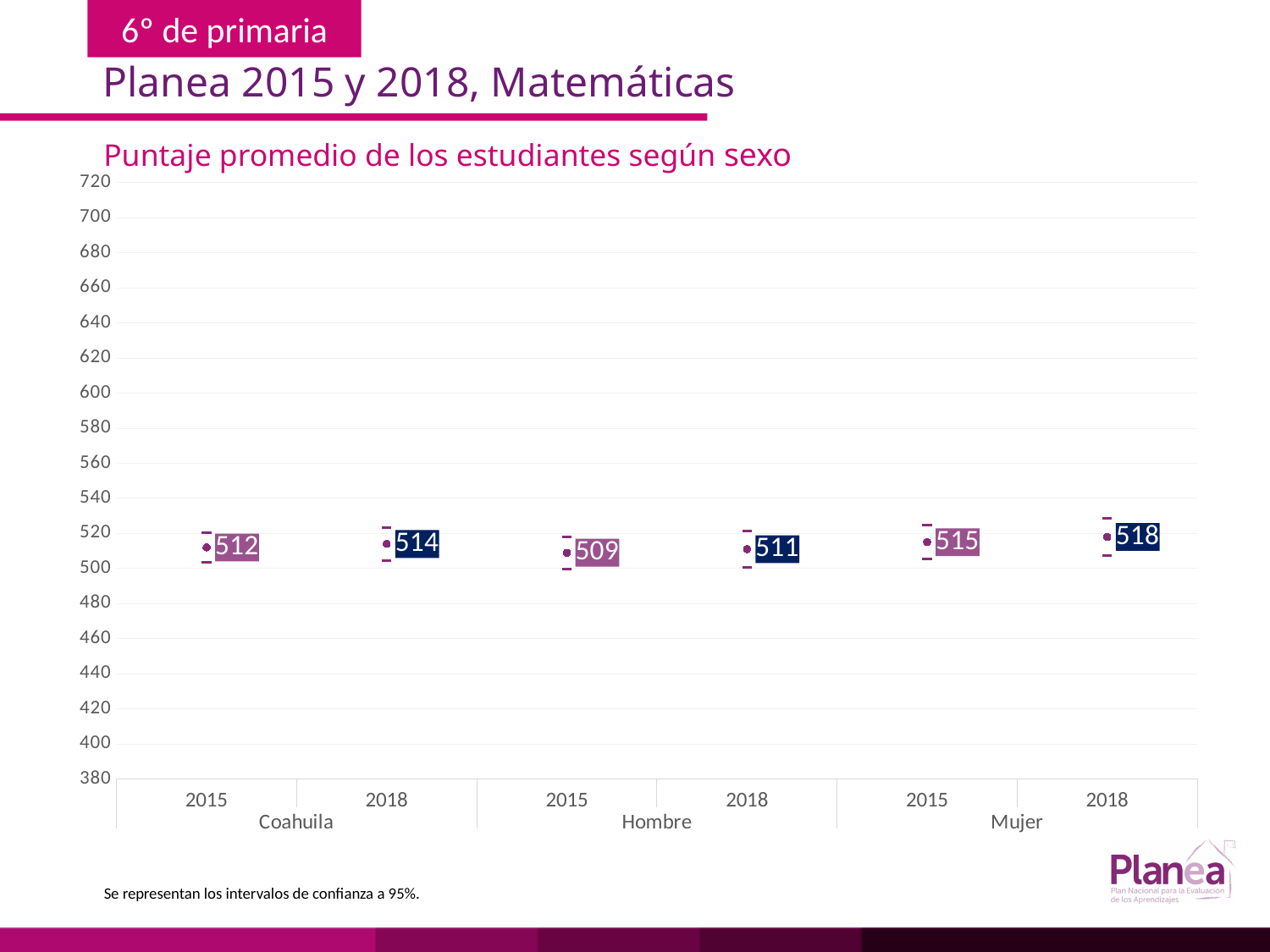
What is the average score for Hombre in 2018? 511 How many data points are plotted on the chart? 6 What is the average score for Coahuila in 2015? 512 Which is larger, the Hombre 2015 score or the Mujer 2015 score? Mujer 2015 What is the average score for Mujer in 2018? 518 By how much did the Coahuila average score change from 2015 to 2018? 2 What is the title of the chart? Puntaje promedio de los estudiantes según sexo Which group and year has the highest average score? Mujer 2018 Do the scores for each group rise or fall from 2015 to 2018? rise Which group and year has the lowest average score? Hombre 2015 What is the difference between the Mujer 2018 score and the Hombre 2018 score? 7 What is the average score for Mujer in 2015? 515